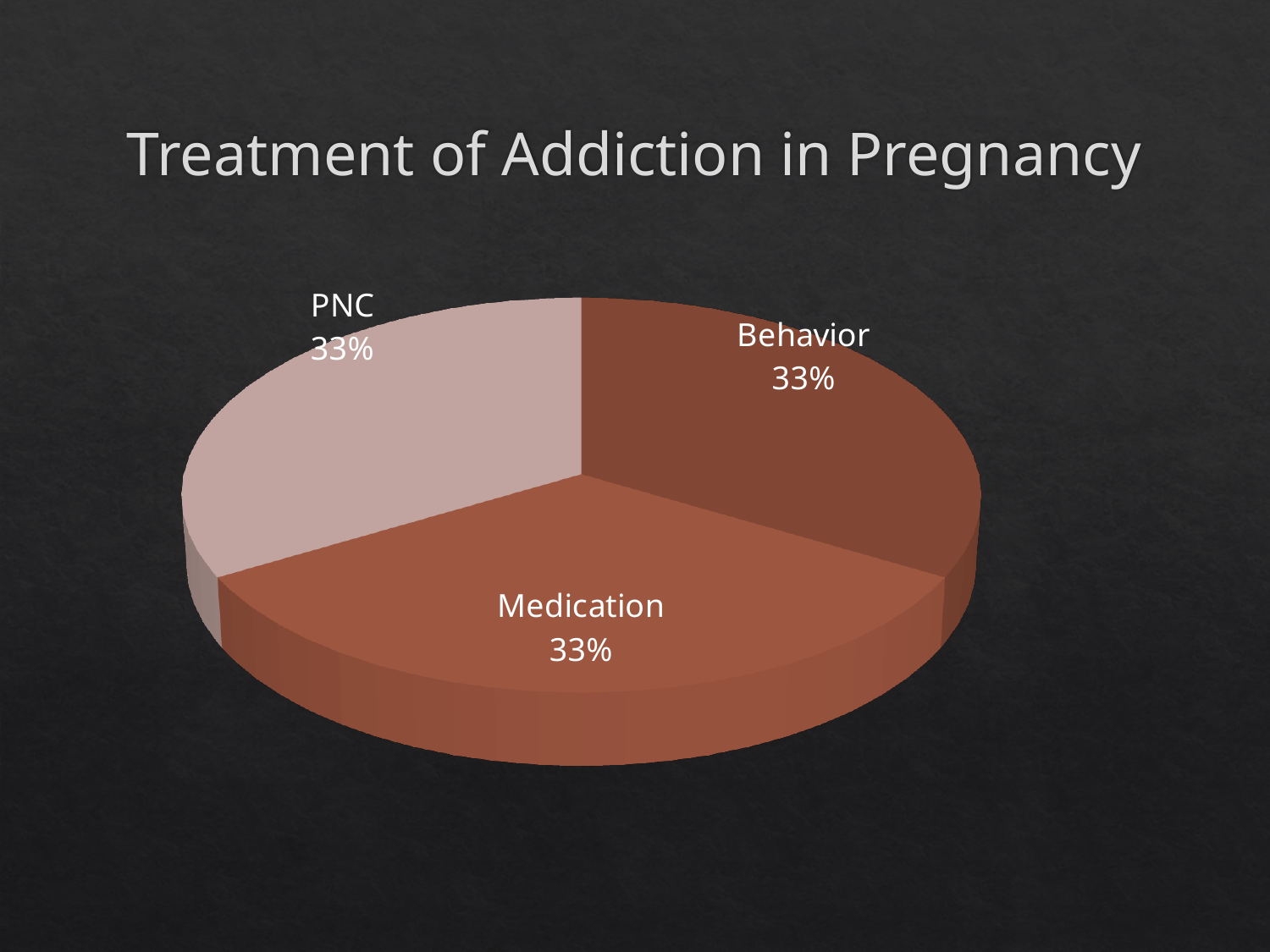
What kind of chart is shown on the slide? pie chart What share of the pie does the Medication slice represent? 33% What share of the pie does the Behavior slice represent? 33% Which slice is labelled with the lightest colour in the pie chart? PNC What is the difference between the PNC share and the Behavior share? 0% What is the title of the chart? Treatment of Addiction in Pregnancy What share of the pie does the PNC slice represent? 33% How many slices does the pie chart have? 3 Is the value for Medication greater or less than 50%? less